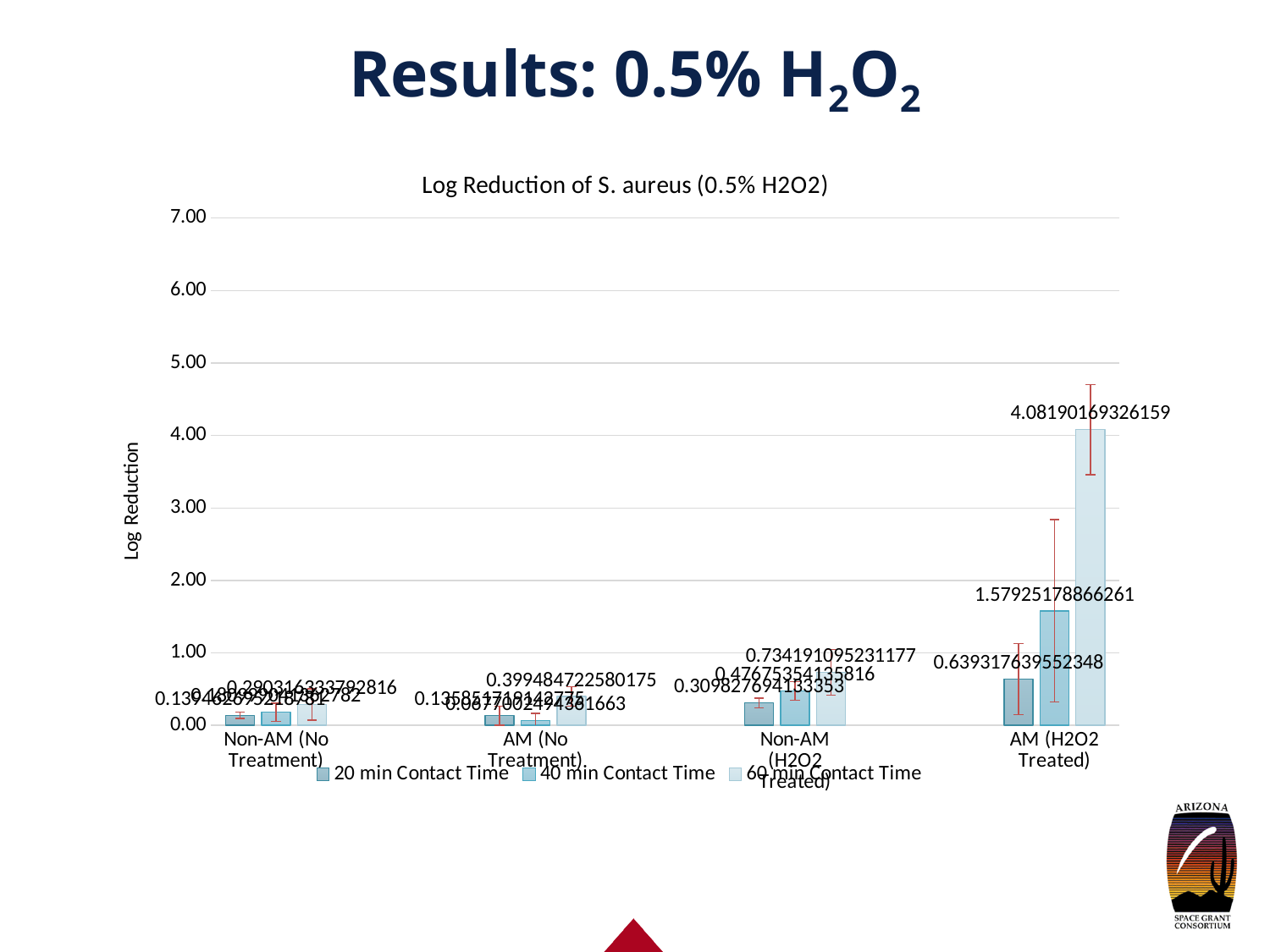
What is the log reduction for AM (H2O2 Treated) at 20 min Contact Time? 0.639317639552348 What is the log reduction for AM (No Treatment) at 60 min Contact Time? 0.399484722580175 For AM (H2O2 Treated), which is larger: the 40 min Contact Time value or the 60 min Contact Time value? 60 min Contact Time How many categories are shown on the x axis? 4 What is the log reduction for AM (H2O2 Treated) at 60 min Contact Time? 4.08190169326159 What is the log reduction for AM (H2O2 Treated) at 40 min Contact Time? 1.57925178866261 What is the log reduction for Non-AM (H2O2 Treated) at 60 min Contact Time? 0.734191095231177 How many series does the legend list? 3 Which category has the highest log reduction bar in the chart? AM (H2O2 Treated) What kind of chart is shown on the slide? Bar chart Is the value for AM (H2O2 Treated) at 40 min Contact Time greater or less than 2.00? less What is the difference between the 60 min and 40 min Contact Time values for AM (H2O2 Treated)? 2.50264990459898